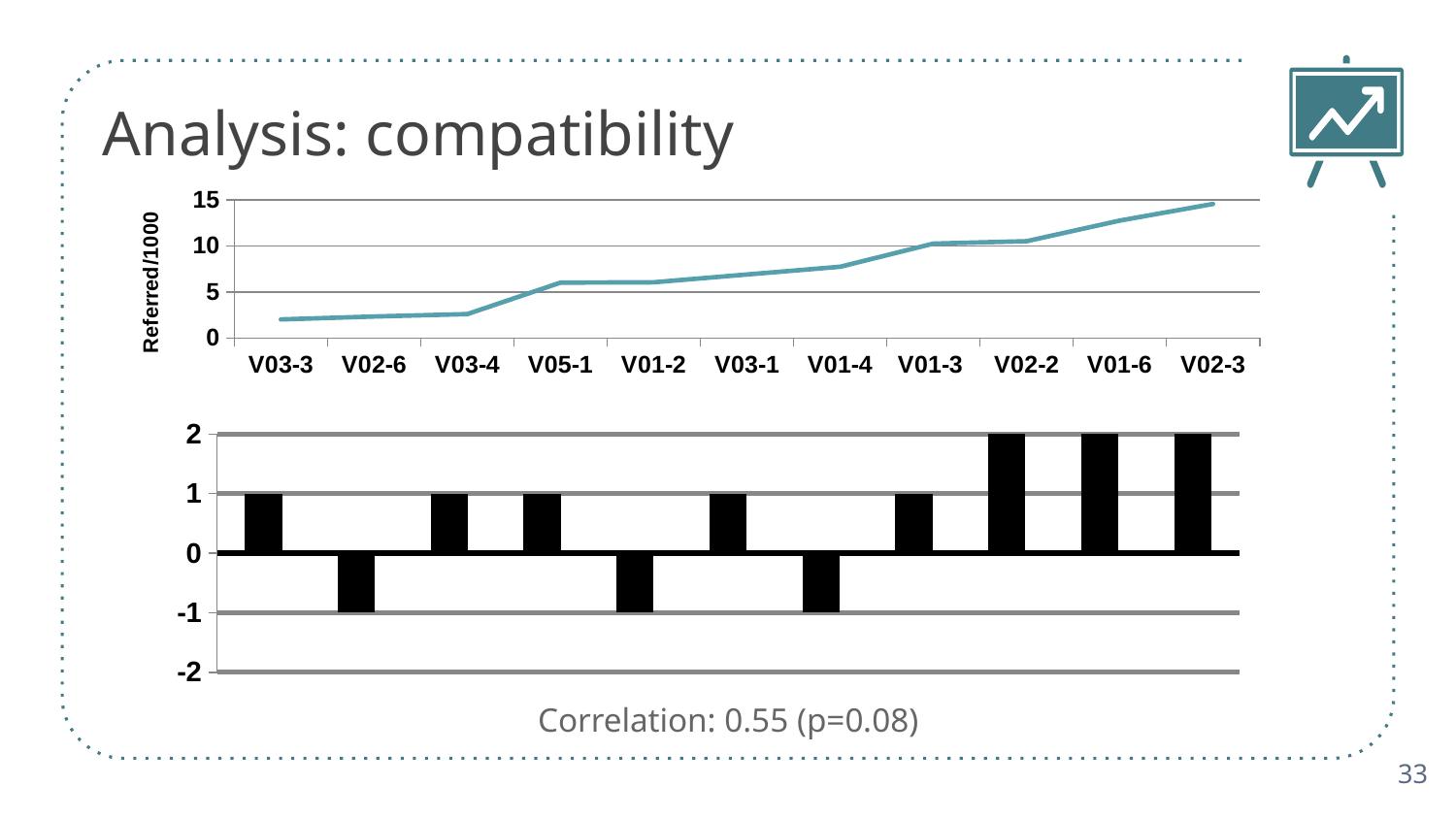
What kind of chart is the top chart on the slide? line chart In the top chart, is the value for V02-3 greater or less than 10? greater In the bottom chart, how many bars are there? 11 In the top chart, is the value for V01-4 greater or less than 10? less In the top chart, do the values generally rise or fall from V03-3 to V02-3? rise In the top chart, which category has the highest value? V02-3 What kind of chart is the bottom chart on the slide? bar chart In the top chart, is the value for V03-3 greater or less than 5? less In the bottom chart, what is the value of the last (rightmost) bar? 2 In the top chart, how many categories are shown on the x axis? 11 In the top chart, what is the label of the y axis? Referred/1000 In the top chart, which has the larger value, V02-3 or V03-3? V02-3